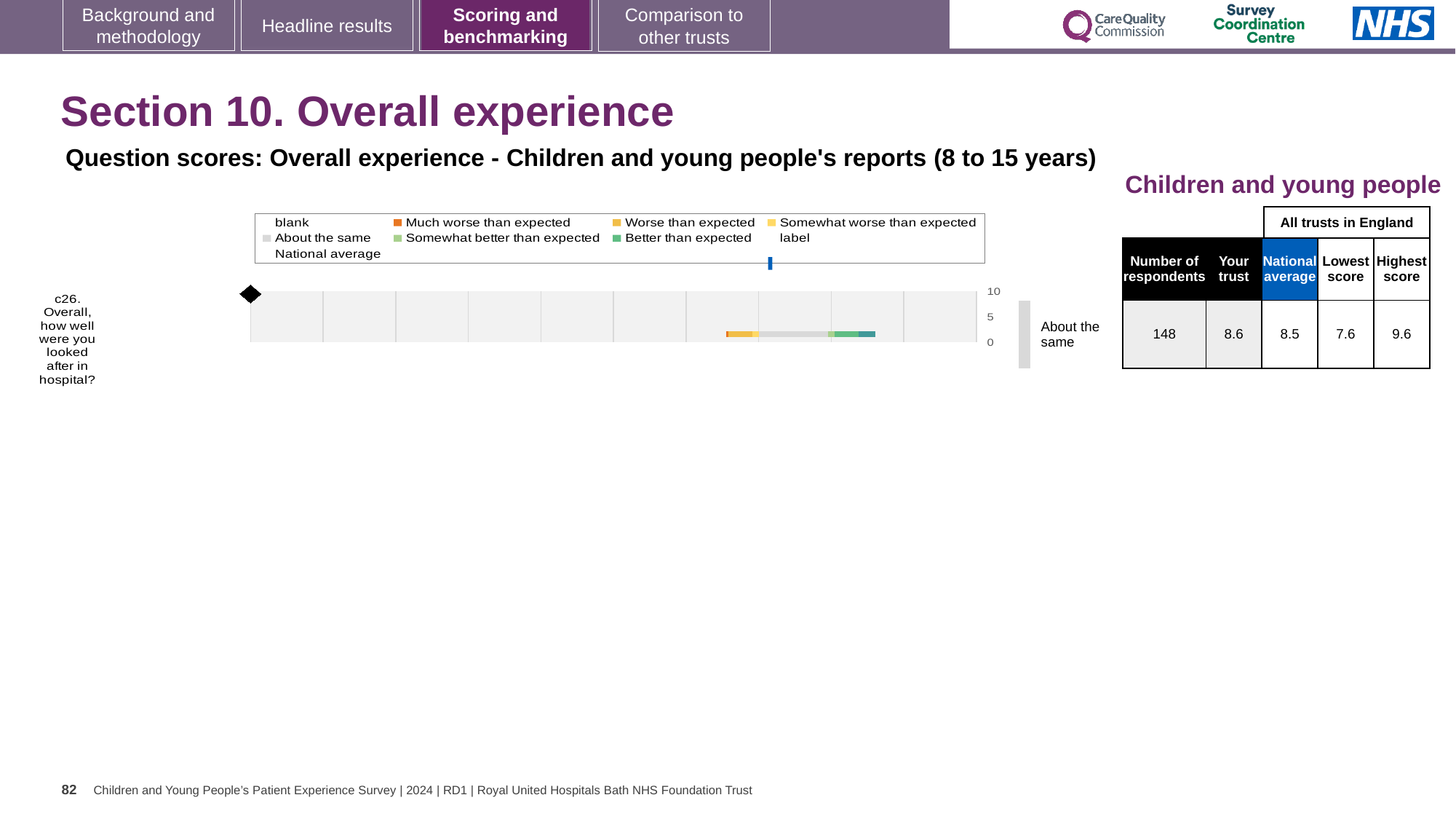
What kind of chart is shown on the slide? bar chart What is the national average score for question c26? 8.5 What is the maximum value shown on the chart's score axis? 10 What is the trust's score for question c26, as shown in the table? 8.6 What is the highest score among all trusts in England for question c26? 9.6 What is the lowest score among all trusts in England for question c26? 7.6 How many survey questions are plotted in the chart? 1 Is the trust's score for question c26 higher or lower than the national average? higher How many respondents answered question c26? 148 What is the difference between the highest and lowest trust scores for question c26? 2.0 Which question is plotted in the chart? c26. Overall, how well were you looked after in hospital? How is the trust's result for question c26 categorised relative to other trusts? About the same